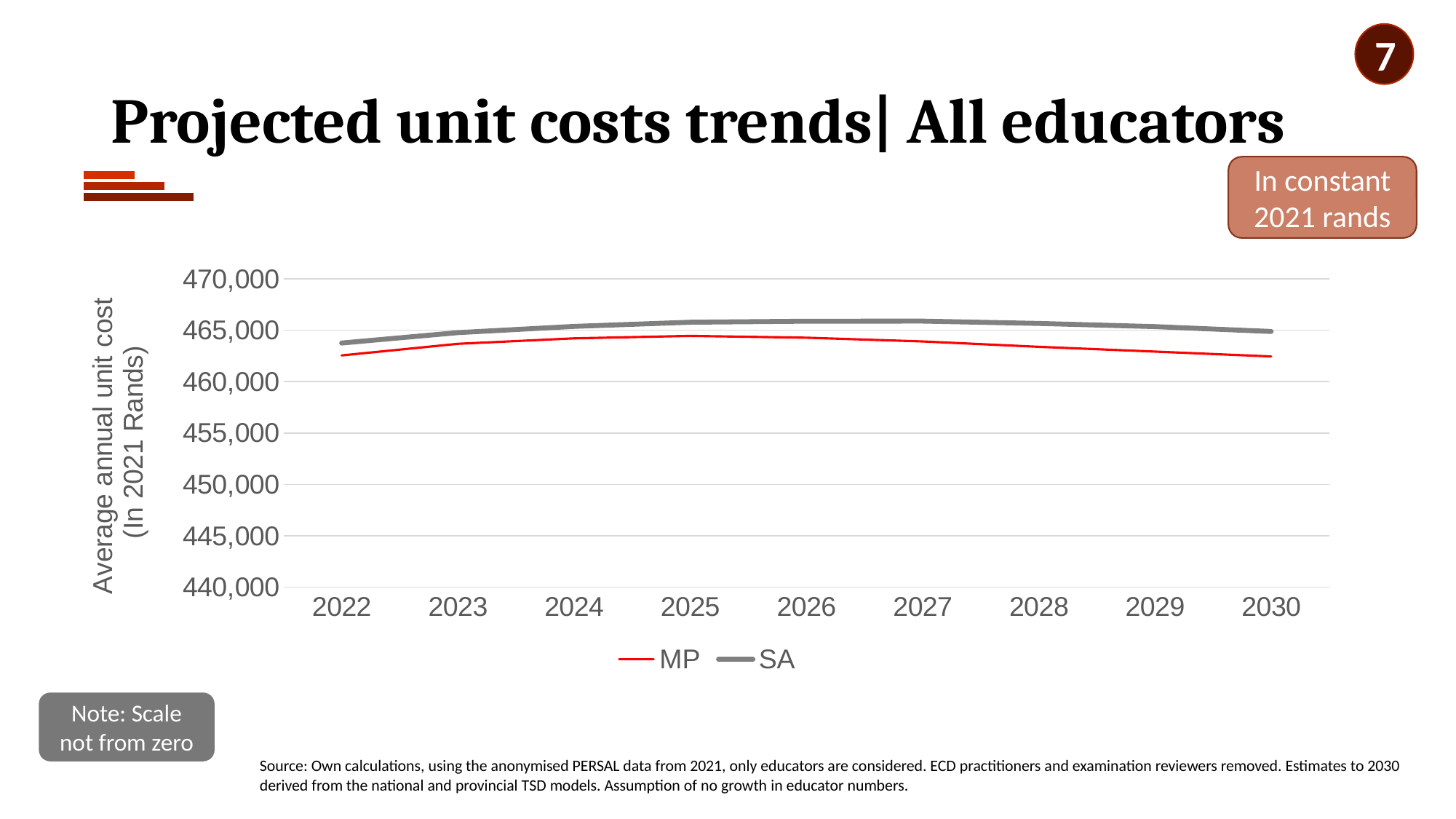
Which series has the higher value in 2030, MP or SA? SA What kind of chart is shown on the slide? line chart Does the MP line rise or fall between 2025 and 2030? fall What is the title of the slide's chart? Projected unit costs trends| All educators Does the SA line rise or fall between 2022 and 2025? rise How many years are plotted along the x axis? 9 Is the value for MP in 2022 greater or less than 465,000? less How many series does the legend list? 2 Is the value for MP in 2030 greater or less than 460,000? greater Is the value for SA in 2026 greater or less than 465,000? greater What colour is the SA line in the chart? grey Which series has the higher value in 2022, MP or SA? SA